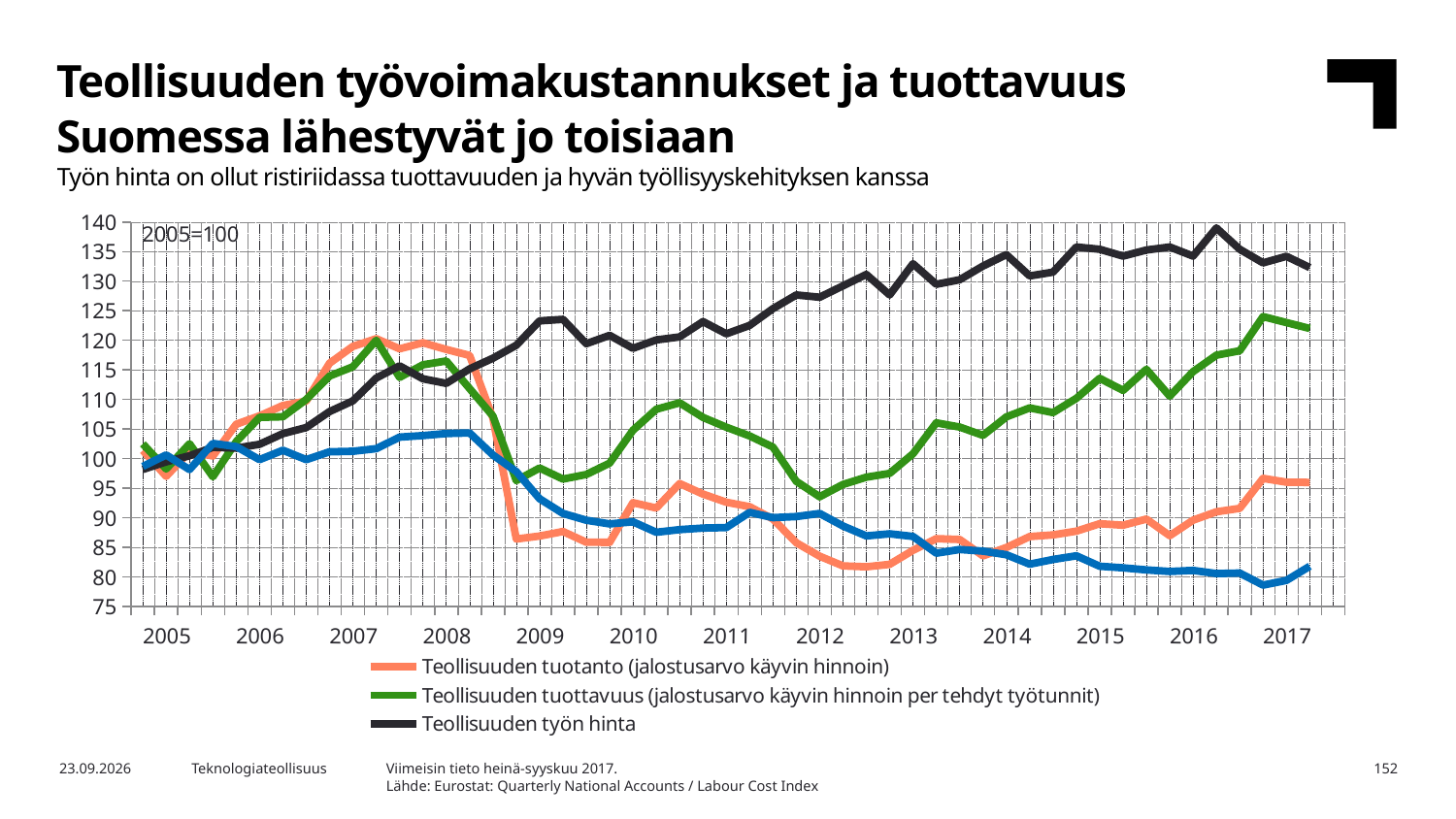
Is the value for Teollisuuden tuottavuus in 2012 greater or less than 105? less In 2016, which is higher: Teollisuuden työn hinta or Teollisuuden tuottavuus? Teollisuuden työn hinta Does the line for Teollisuuden työn hinta rise or fall overall from 2005 to 2017? rises How many series does the legend list? 3 Is the value for Teollisuuden tuotanto at the start of 2008 greater or less than 115? greater Is the value for Teollisuuden työn hinta in 2016 greater or less than 130? greater Does the line for Teollisuuden tuotanto rise or fall between 2008 and 2009? falls What base-year index is noted in the top-left corner of the chart? 2005=100 What kind of chart is shown on the slide? line chart Which series is drawn in black? Teollisuuden työn hinta